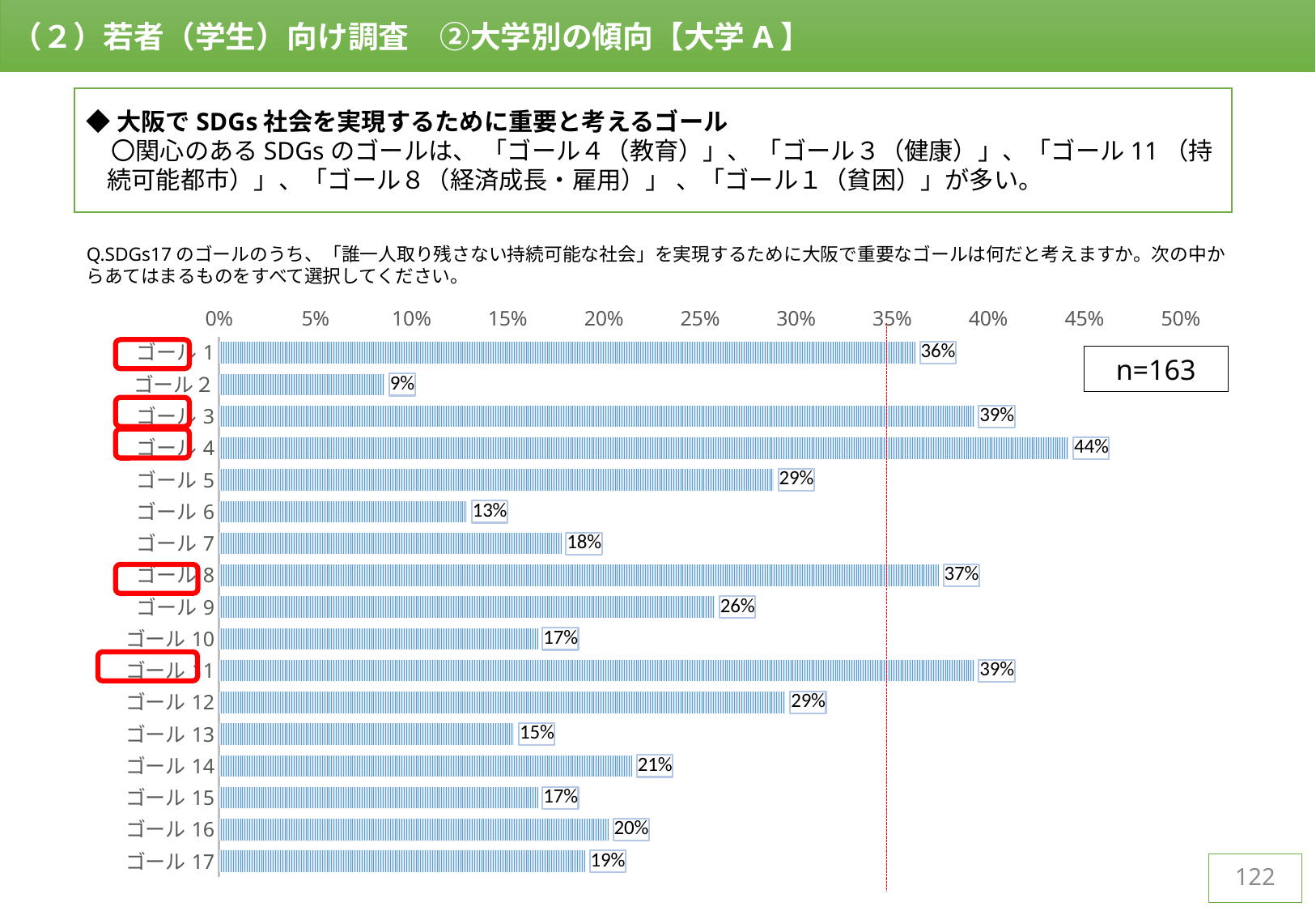
What is the value for ゴール 17? 19% Is the value for ゴール 14 greater or less than 25%? less What is the value for ゴール 2? 9% Which is larger, the value for ゴール 5 or the value for ゴール 9? ゴール 5 What kind of chart is shown on the slide? bar chart What is the value for ゴール 8? 37% Which goal has the highest value? ゴール 4 What is the value for ゴール 4? 44% How many goals (categories) are shown in the chart? 17 Which goal has the lowest value? ゴール 2 What is the difference between the values for ゴール 4 and ゴール 1? 8% What is the sample size (n) shown next to the chart? n=163